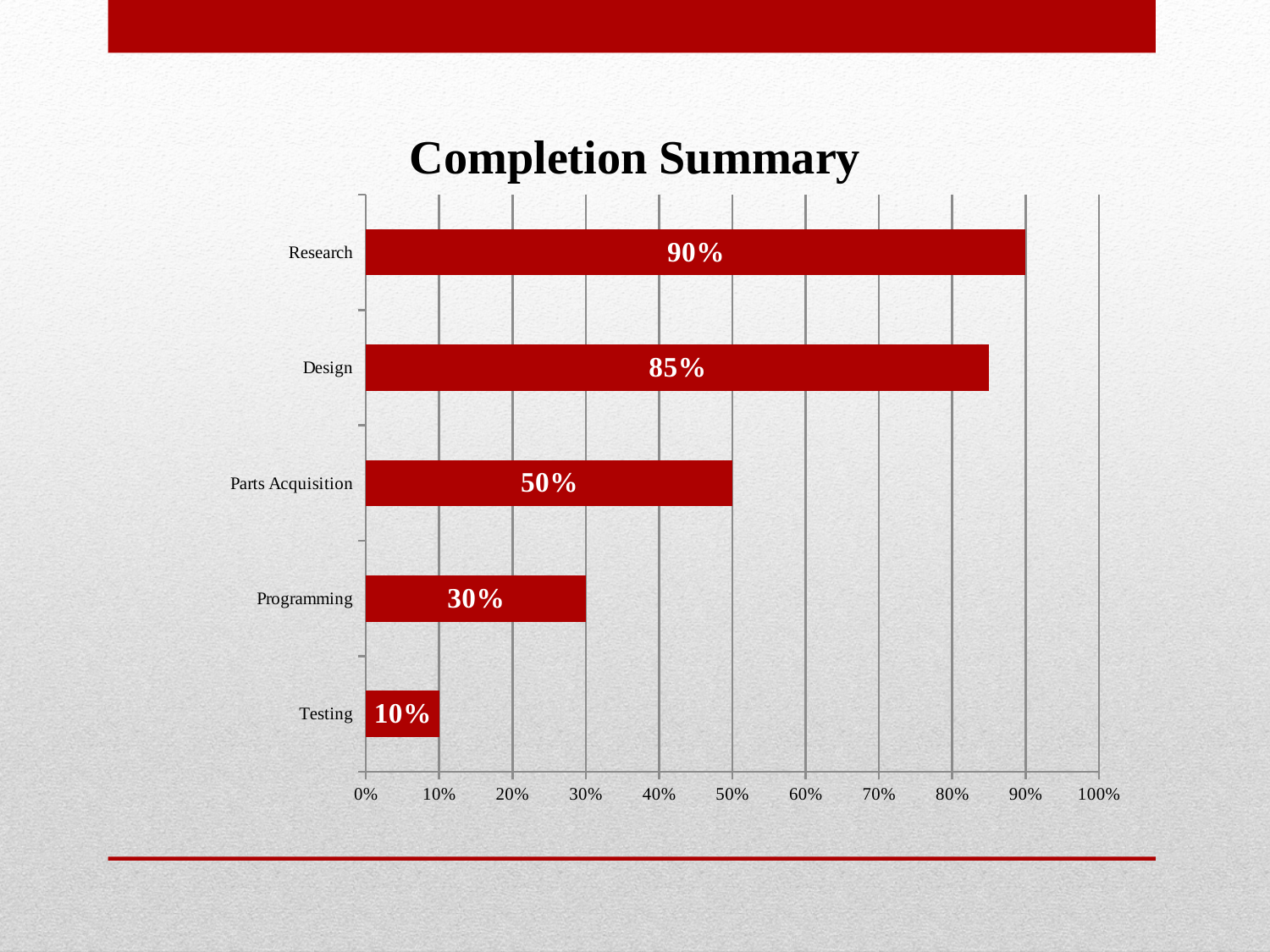
How many categories are shown in the chart? 5 What is the completion value for Testing? 10% What is the difference between the Research and Design values? 5% Which category has the lowest completion value? Testing What kind of chart is shown on the slide? Bar chart Is the value for Programming greater or less than 40%? less What is the difference between the Parts Acquisition and Programming values? 20% What is the title of the chart? Completion Summary Which category has the highest completion value? Research What is the completion value for Parts Acquisition? 50% What is the completion value for Research? 90% Which is larger, the value for Design or the value for Programming? Design